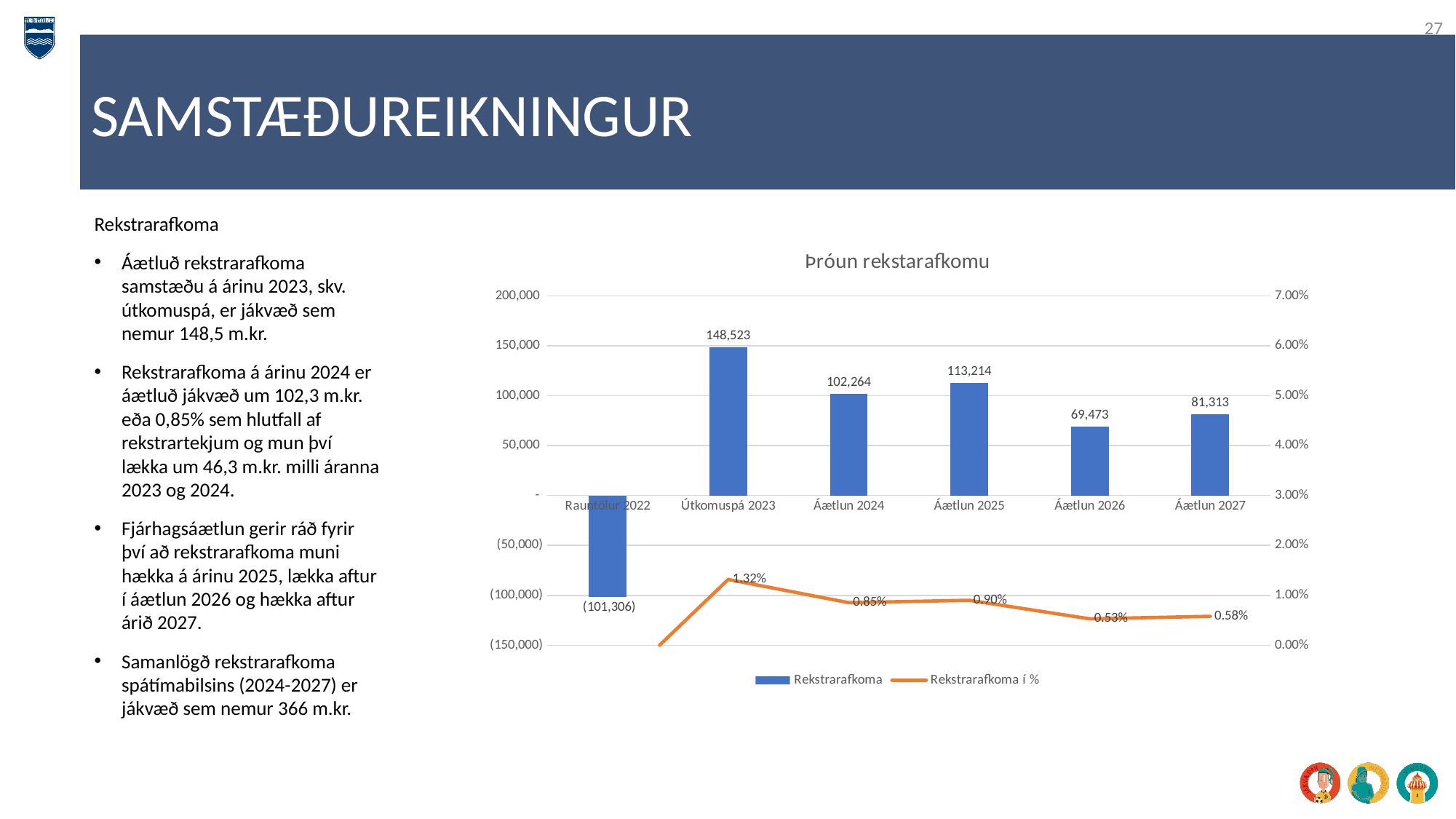
Which is larger, the Rekstrarafkoma for Áætlun 2024 or for Áætlun 2027? Áætlun 2024 How many series does the legend list? 2 What is the Rekstrarafkoma í % value for Áætlun 2026? 0.53% What is the title of the chart? Þróun rekstarafkomu What is the value of Rekstrarafkoma for Útkomuspá 2023? 148,523 What is the difference in Rekstrarafkoma between Áætlun 2025 and Áætlun 2026? 43,741 Which category has the highest Rekstrarafkoma bar? Útkomuspá 2023 What is the Rekstrarafkoma í % value for Áætlun 2024? 0.85% How many categories are shown on the x axis of the chart? 6 What is the value of Rekstrarafkoma for Rauntölur 2022? (101,306) Which category has the lowest Rekstrarafkoma bar? Rauntölur 2022 Is the Rekstrarafkoma value for Áætlun 2026 greater or less than 100,000? less